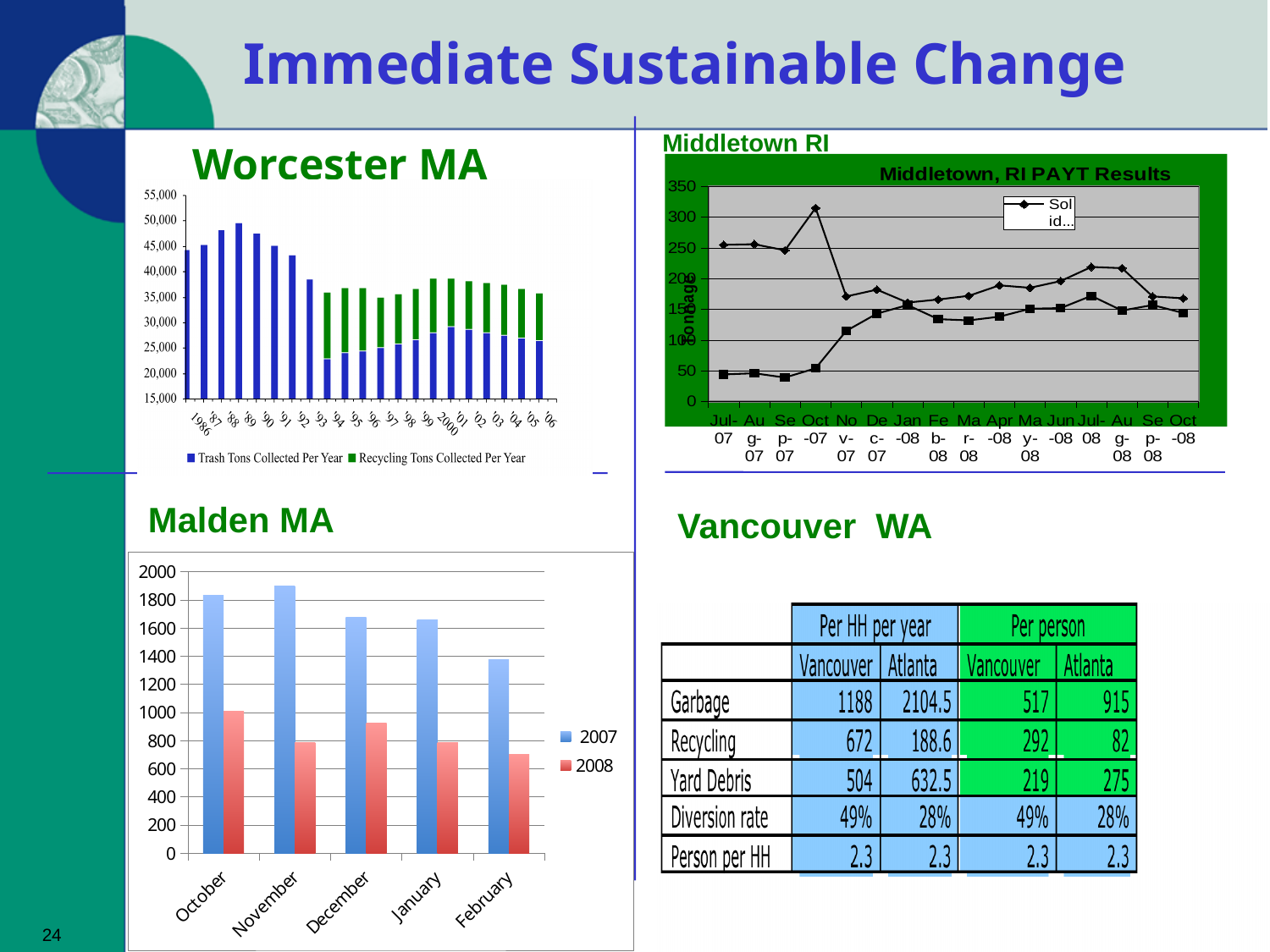
In the Worcester MA chart, is the value for Trash Tons Collected Per Year in 1988 greater or less than 45,000? greater How many series does the legend of the Worcester MA chart list? 2 How many series does the legend of the Malden MA chart list? 2 In the Malden MA chart, which month has the highest value for 2007? November In the Worcester MA chart, is the value for Trash Tons Collected Per Year in 1993 greater or less than 30,000? less What kind of chart is the Middletown RI chart? line chart In the Middletown RI chart, is the value of the square-marker series at Jul-07 greater or less than 100? less How many months are shown on the x axis of the Malden MA chart? 5 What is the title printed inside the Middletown RI chart? Middletown, RI PAYT Results What kind of chart is the Worcester MA chart? bar chart